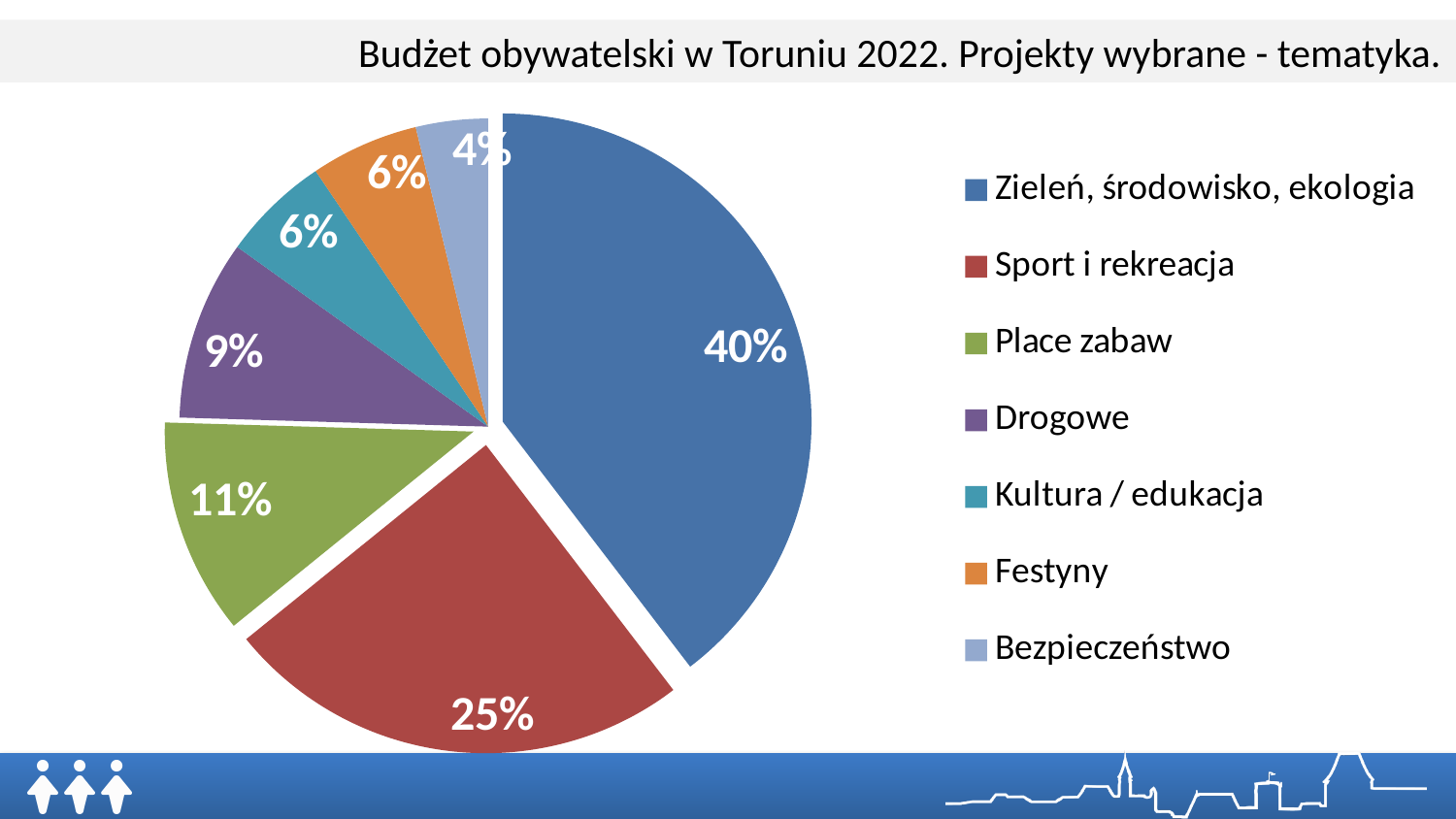
What is the value shown for Place zabaw? 11% What is the value shown for Bezpieczeństwo? 4% What kind of chart is shown on the slide? Pie chart Which category has the largest slice of the pie? Zieleń, środowisko, ekologia What is the difference between the shares of Zieleń, środowisko, ekologia and Sport i rekreacja? 15% What is the title of the chart? Budżet obywatelski w Toruniu 2022. Projekty wybrane - tematyka. How many categories are shown in the pie chart? 7 What share of the pie does Zieleń, środowisko, ekologia have? 40% What is the value shown for Drogowe? 9% What is the value shown for Sport i rekreacja? 25% Which category has the smallest slice of the pie? Bezpieczeństwo Which is larger, the share for Place zabaw or the share for Drogowe? Place zabaw